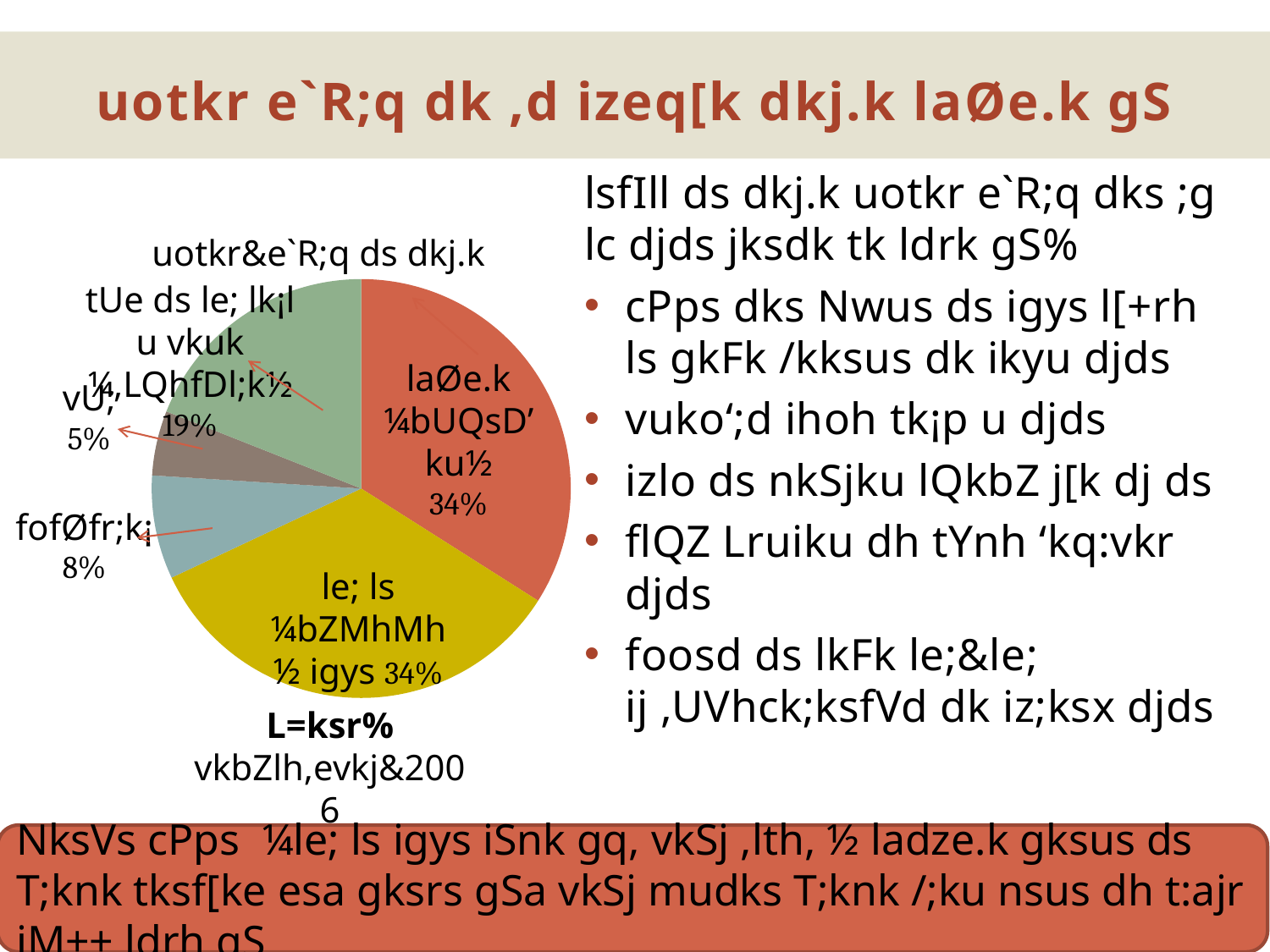
What is the title of the pie chart? uotkr&e`R;q ds dkj.k What percentage is shown for the slice labelled "tUe ds le; lk¡l u vkuk ¼,LQhfDl;k½"? 19% How many slices of the pie chart are labelled 34%? 2 What percentage is shown for the slice labelled "laØe.k ¼bUQsD'ku½"? 34% What percentage is shown for the slice labelled "fofØfr;k¡"? 8% What is the difference between the 19% slice and the 8% slice? 11 percentage points Which slice of the pie chart has the smallest share? vU; (5%) What kind of chart is shown on the slide? pie chart What percentage is shown for the slice labelled "vU;"? 5% What is the largest percentage shown on any slice of the pie chart? 34% Which is larger: the slice labelled "fofØfr;k¡" or the slice labelled "vU;"? fofØfr;k¡ How many slices does the pie chart have? 5